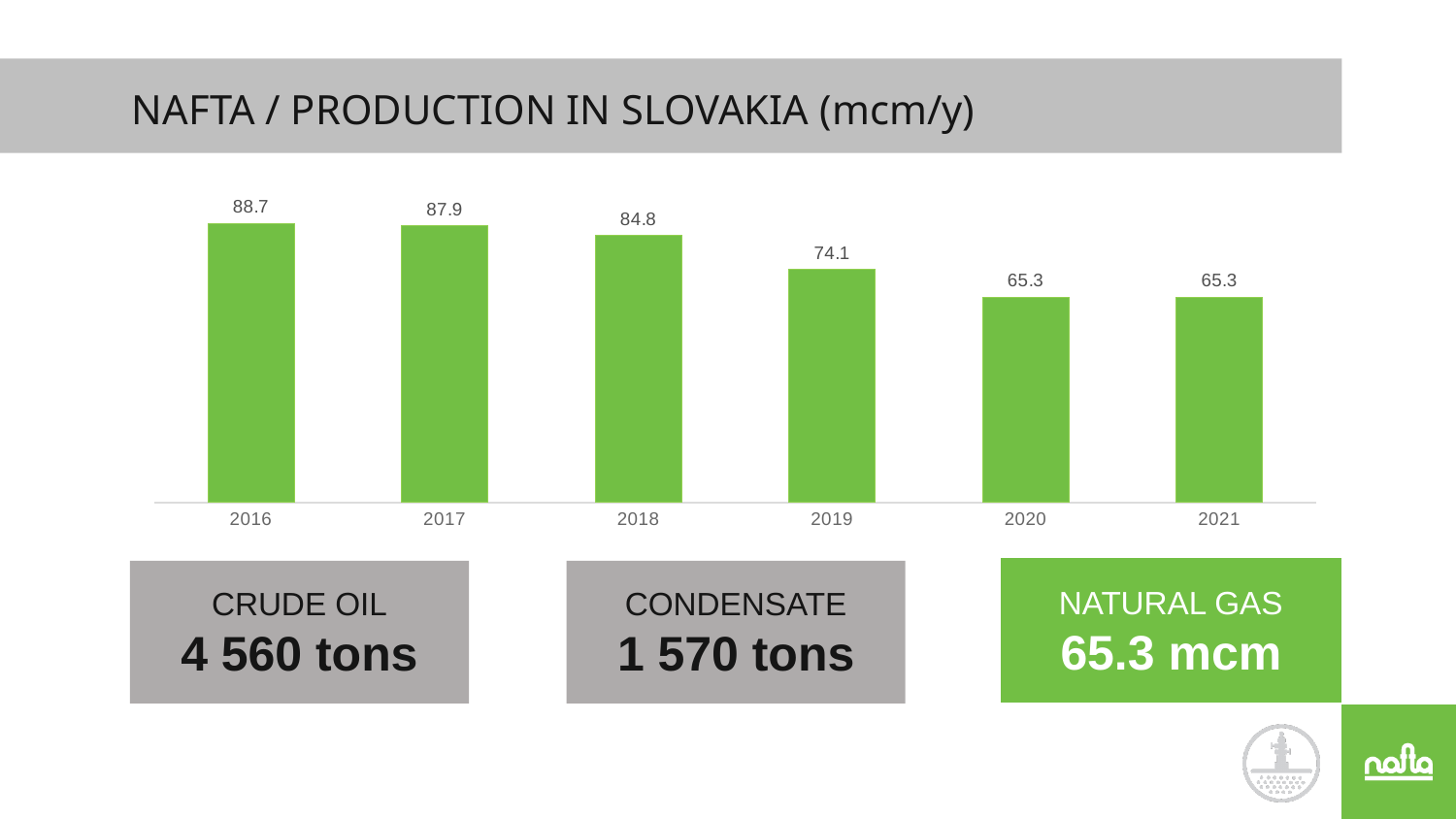
What is the difference between the 2018 and 2019 production values? 10.7 Do the production values rise or fall from 2016 to 2021? fall What is the difference between the 2016 and 2021 production values? 23.4 What is the production value for 2016? 88.7 What is the production value for 2019? 74.1 What kind of chart is shown on the slide? bar chart How many years are shown on the x axis of the chart? 6 What is the title of the slide containing the chart? NAFTA / PRODUCTION IN SLOVAKIA (mcm/y) What colour are the bars in the chart? green What is the production value for 2021? 65.3 Which is larger, the value for 2017 or the value for 2019? 2017 Which year has the highest production value? 2016